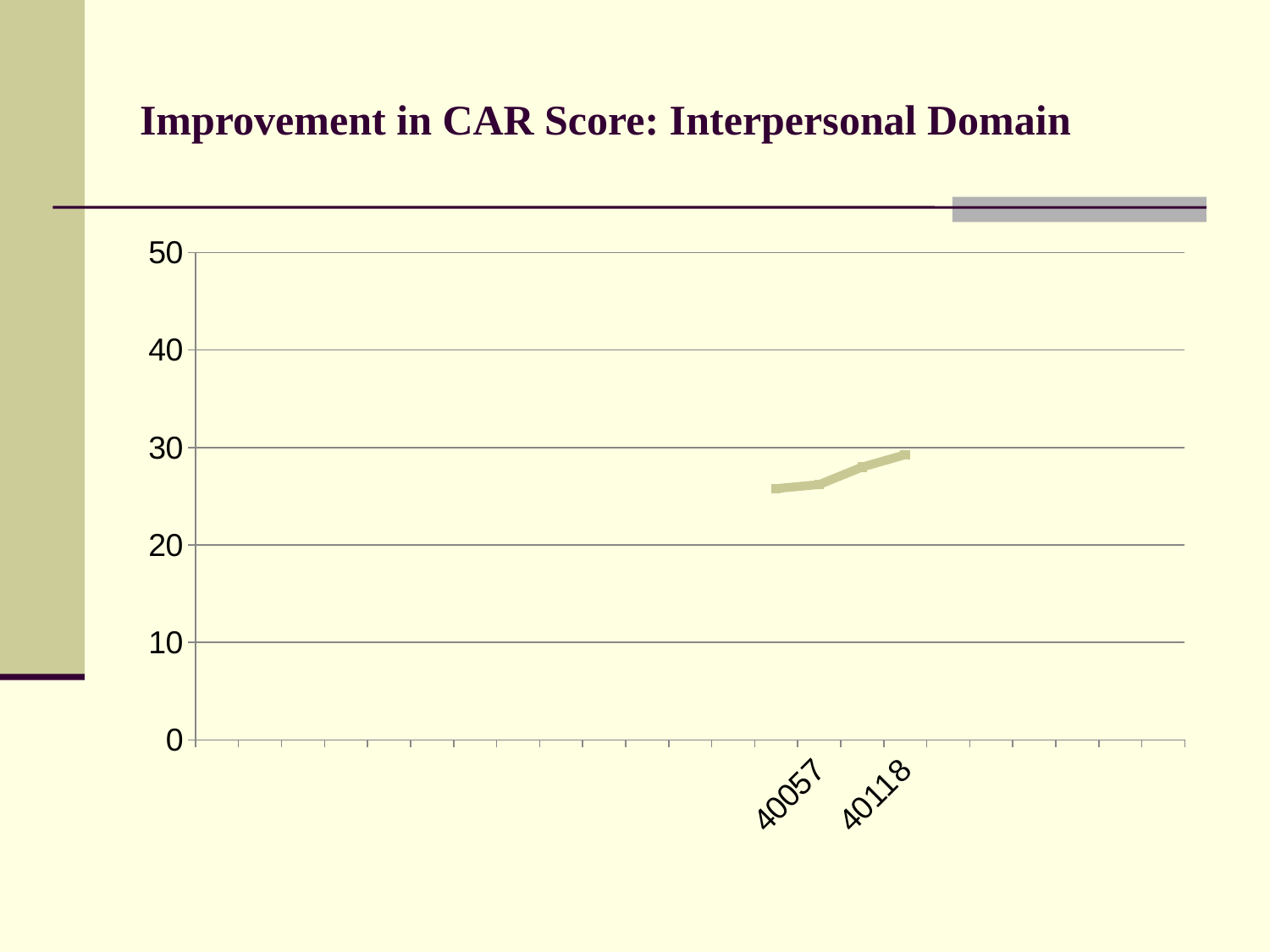
Is the value for 40057 greater or less than 20? greater What is the highest value shown on the y axis? 50 How many category labels are printed on the x axis? 2 Is the value for 40057 greater or less than 30? less What is the title of the chart? Improvement in CAR Score: Interpersonal Domain Do the plotted values rise or fall from left to right along the x axis? rise Is the value for 40118 greater or less than 20? greater What kind of chart is shown on the slide? line chart Which has the larger value, 40057 or 40118? 40118